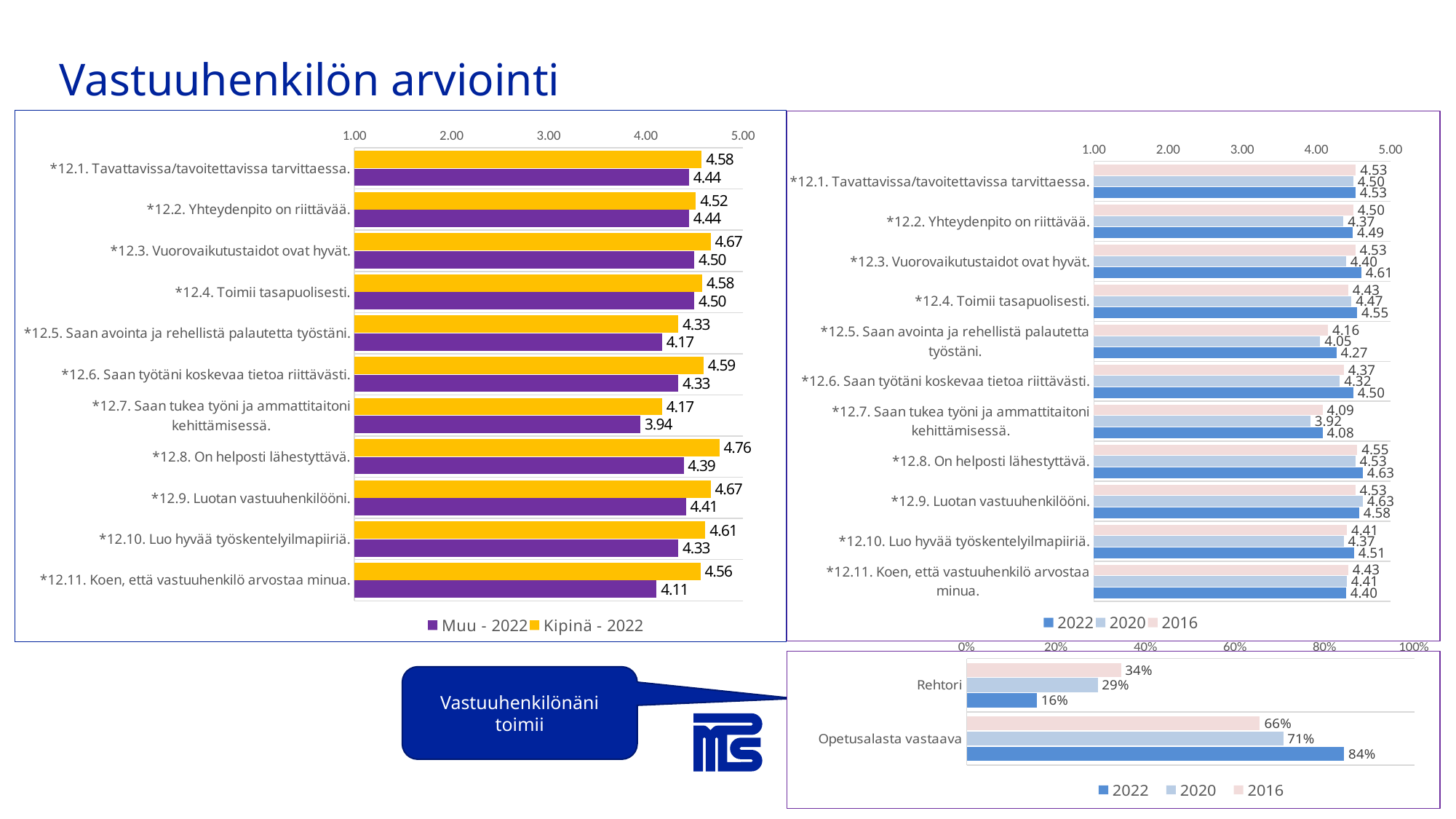
In the bottom-right chart, what is the 2022 value for 'Opetusalasta vastaava'? 84% In the left chart, what is the Kipinä - 2022 value for '*12.8. On helposti lähestyttävä.'? 4.76 In the left chart, what is the Muu - 2022 value for '*12.7. Saan tukea työni ja ammattitaitoni kehittämisessä.'? 3.94 In the left chart, which statement has the highest Kipinä - 2022 value? *12.8. On helposti lähestyttävä. In the bottom-right chart, what is the 2016 value for 'Rehtori'? 34% In the top-right chart, how many series does the legend list? 3 In the left chart, what is the difference between the Kipinä - 2022 and Muu - 2022 values for '*12.11. Koen, että vastuuhenkilö arvostaa minua.'? 0.45 In the left chart, how many series does the legend list? 2 In the top-right chart, which is larger for '*12.5. Saan avointa ja rehellistä palautetta työstäni.': the 2022 value or the 2016 value? 2022 In the top-right chart, what is the 2022 value for '*12.3. Vuorovaikutustaidot ovat hyvät.'? 4.61 What kind of chart is the bottom-right chart? bar chart In the top-right chart, what is the 2020 value for '*12.7. Saan tukea työni ja ammattitaitoni kehittämisessä.'? 3.92